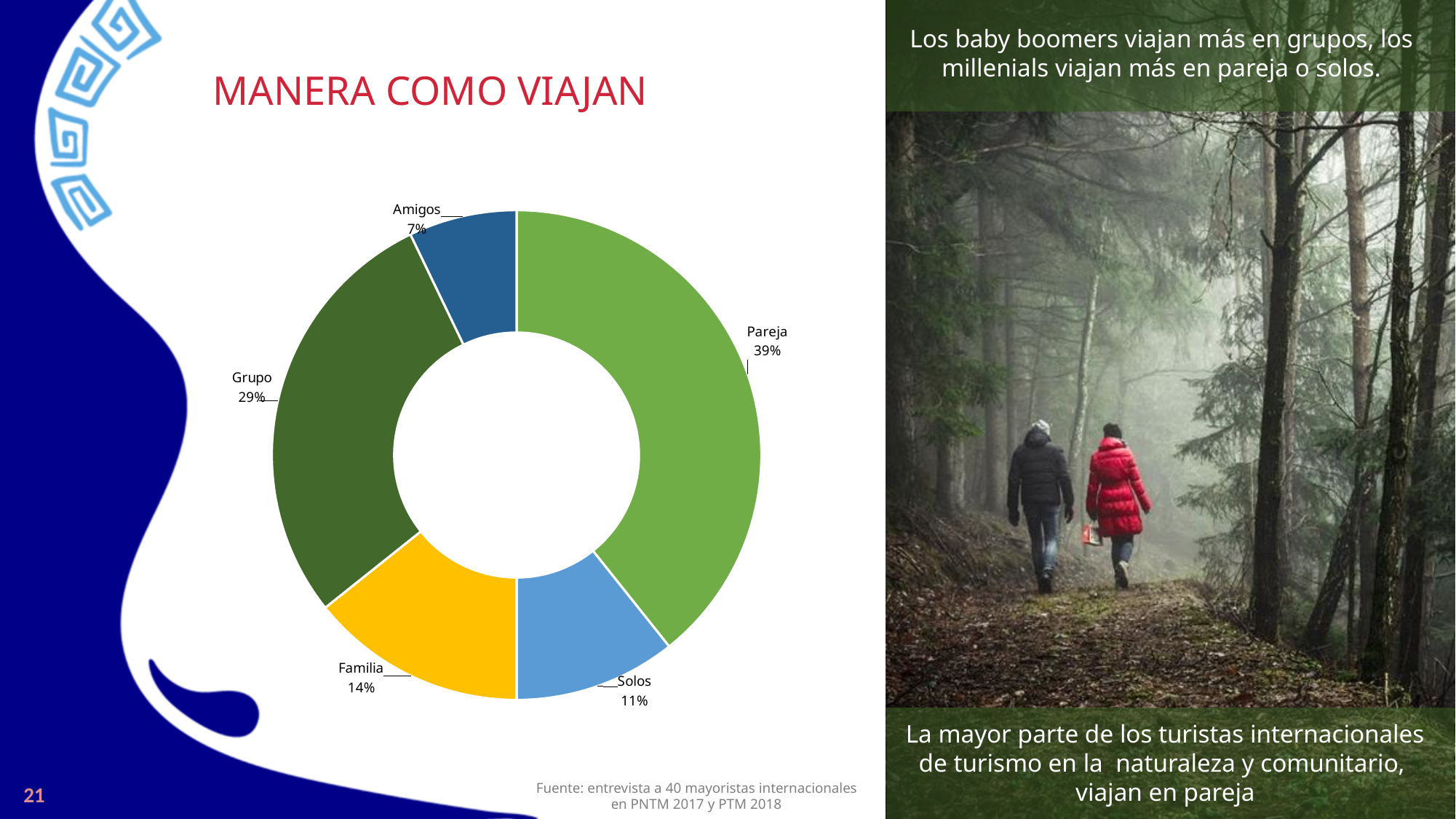
What is the title of the chart on the slide? MANERA COMO VIAJAN Which category has the smallest share? Amigos What is the value for Solos? 11% What is the difference between the shares for Pareja and Grupo? 10% What kind of chart is shown on the slide? Doughnut chart What is the value for Amigos? 7% What is the value for Familia? 14% What is the value for Grupo? 29% How many categories are shown in the chart? 5 Which category has the largest share? Pareja What share of the chart does Pareja represent? 39% Which is larger, the share for Familia or the share for Solos? Familia